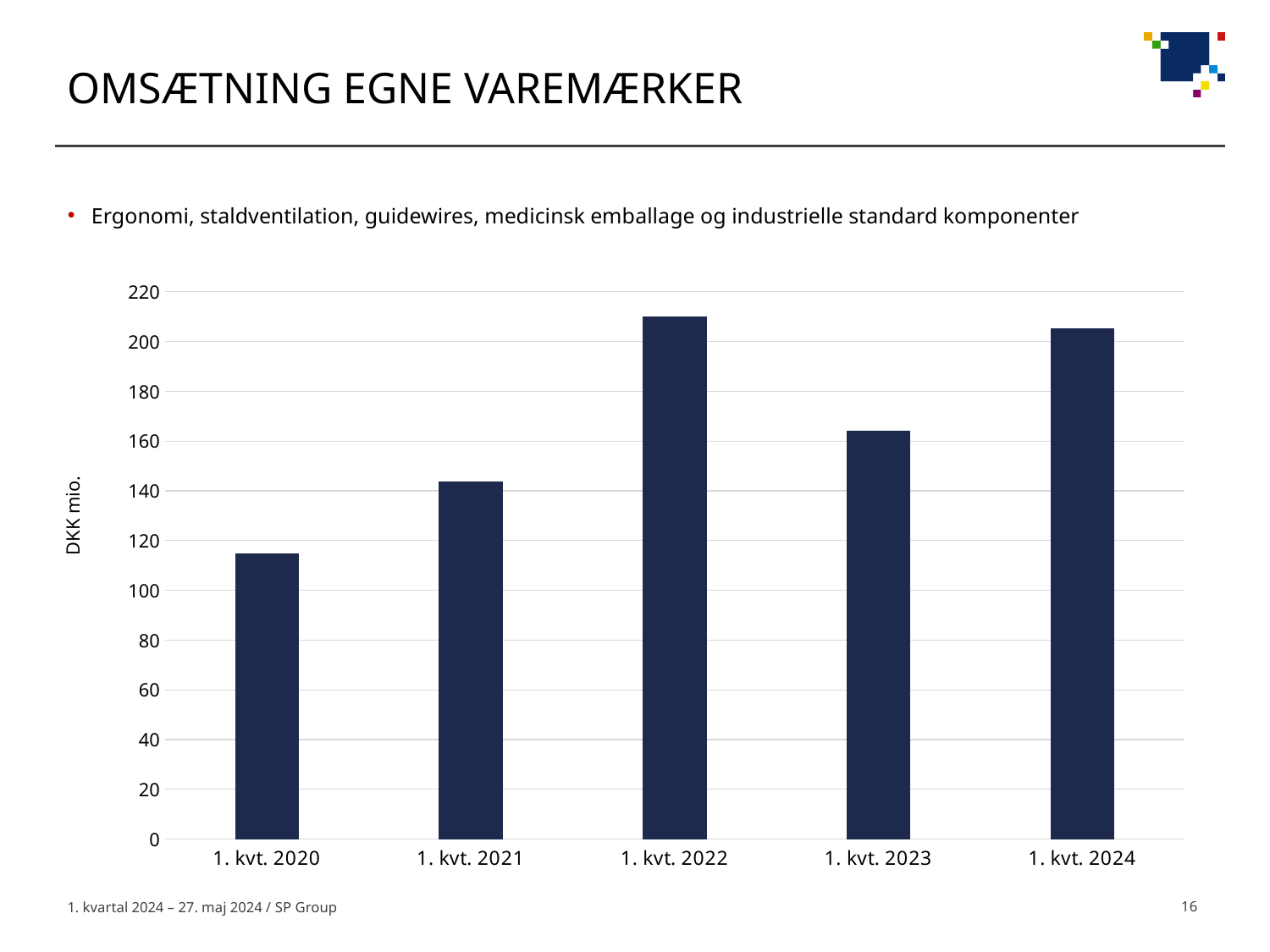
How many quarters are plotted on the chart? 5 Which is larger, the value for 1. kvt. 2022 or the value for 1. kvt. 2023? 1. kvt. 2022 Is the value for 1. kvt. 2023 greater or less than 180? less Is the value for 1. kvt. 2020 greater or less than 100? greater Which is larger, the value for 1. kvt. 2021 or the value for 1. kvt. 2023? 1. kvt. 2023 Is the value for 1. kvt. 2022 greater or less than 200? greater Does the value rise or fall from 1. kvt. 2022 to 1. kvt. 2023? fall What is the label on the vertical axis of the chart? DKK mio. What kind of chart is shown on the slide? bar chart Which quarter has the lowest value on the chart? 1. kvt. 2020